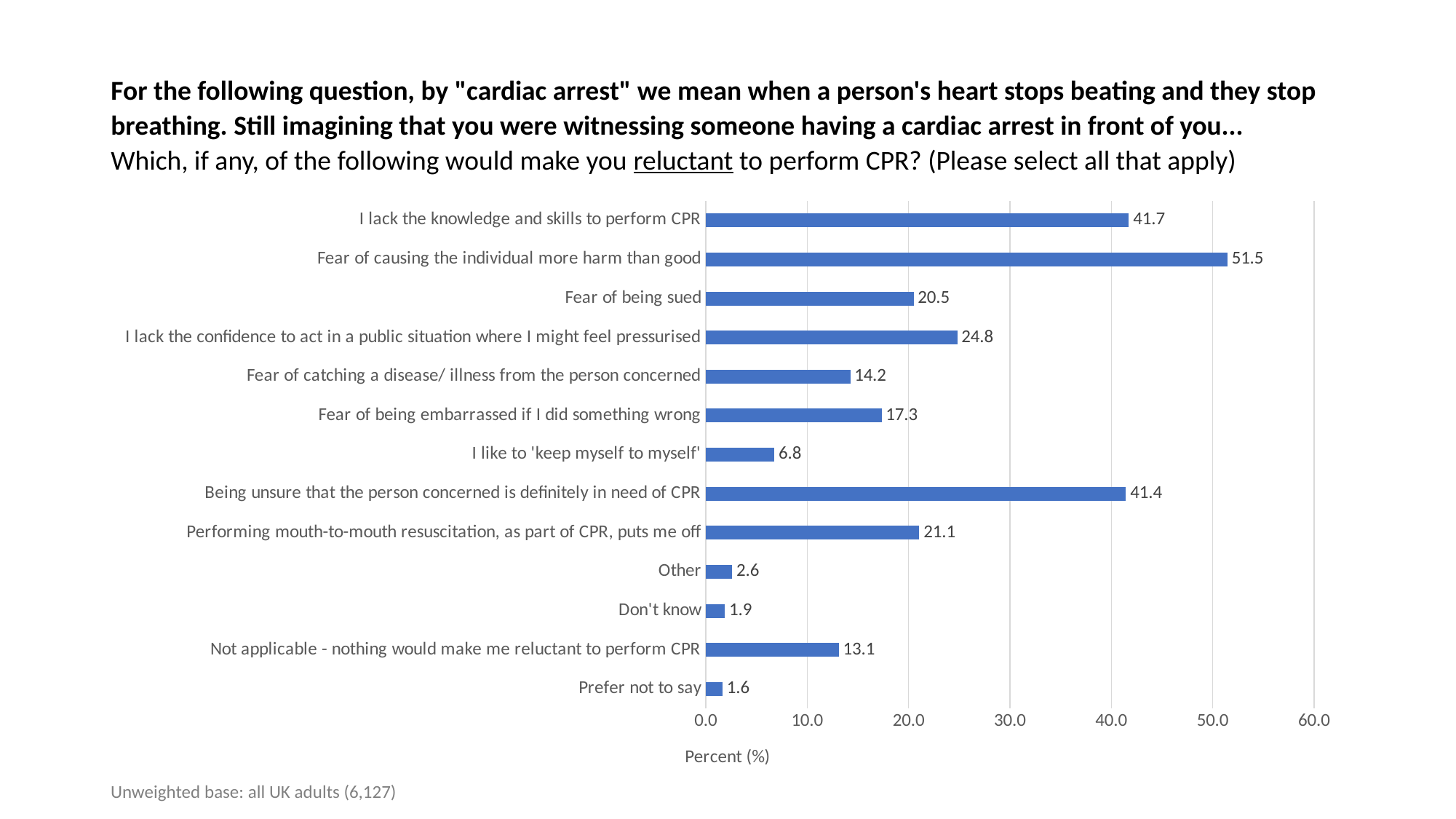
How many categories are shown in the chart? 13 Which category has the lowest percentage? Prefer not to say Which reason has the highest percentage? Fear of causing the individual more harm than good What is the value for 'I like to 'keep myself to myself''? 6.8 What kind of chart is shown on the slide? Bar chart What is the unweighted base stated on the slide? all UK adults (6,127) Which is larger: 'Fear of being embarrassed if I did something wrong' or 'Fear of catching a disease/ illness from the person concerned'? Fear of being embarrassed if I did something wrong What percentage of respondents said 'Fear of being sued' would make them reluctant to perform CPR? 20.5 What is the label of the horizontal axis? Percent (%) What is the value for 'Not applicable - nothing would make me reluctant to perform CPR'? 13.1 What is the difference between 'Fear of causing the individual more harm than good' and 'I lack the knowledge and skills to perform CPR'? 9.8 Is the value for 'I lack the confidence to act in a public situation where I might feel pressurised' greater or less than 20.0? greater